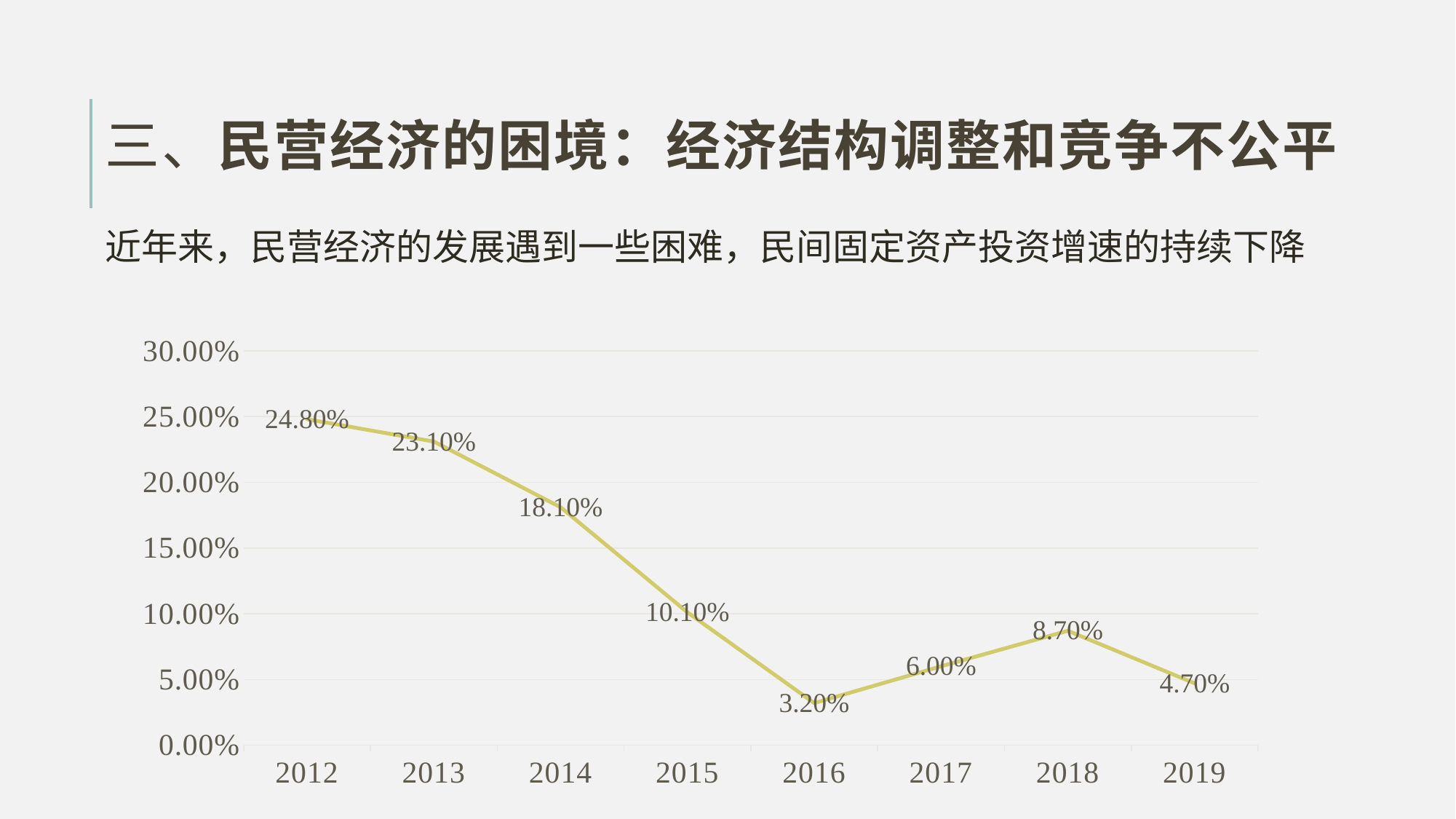
Which year has the highest value? 2012 Is the value for 2013 greater or less than 20.00%? greater What is the difference between the values for 2012 and 2019? 20.10% How many years are plotted on the x axis? 8 What is the value for 2016? 3.20% What kind of chart is shown on the slide? line chart What is the value for 2019? 4.70% What is the value for 2018? 8.70% What is the difference between the values for 2018 and 2017? 2.70% What is the value for 2012? 24.80% Which is larger, the value for 2014 or the value for 2015? 2014 Which year has the lowest value? 2016